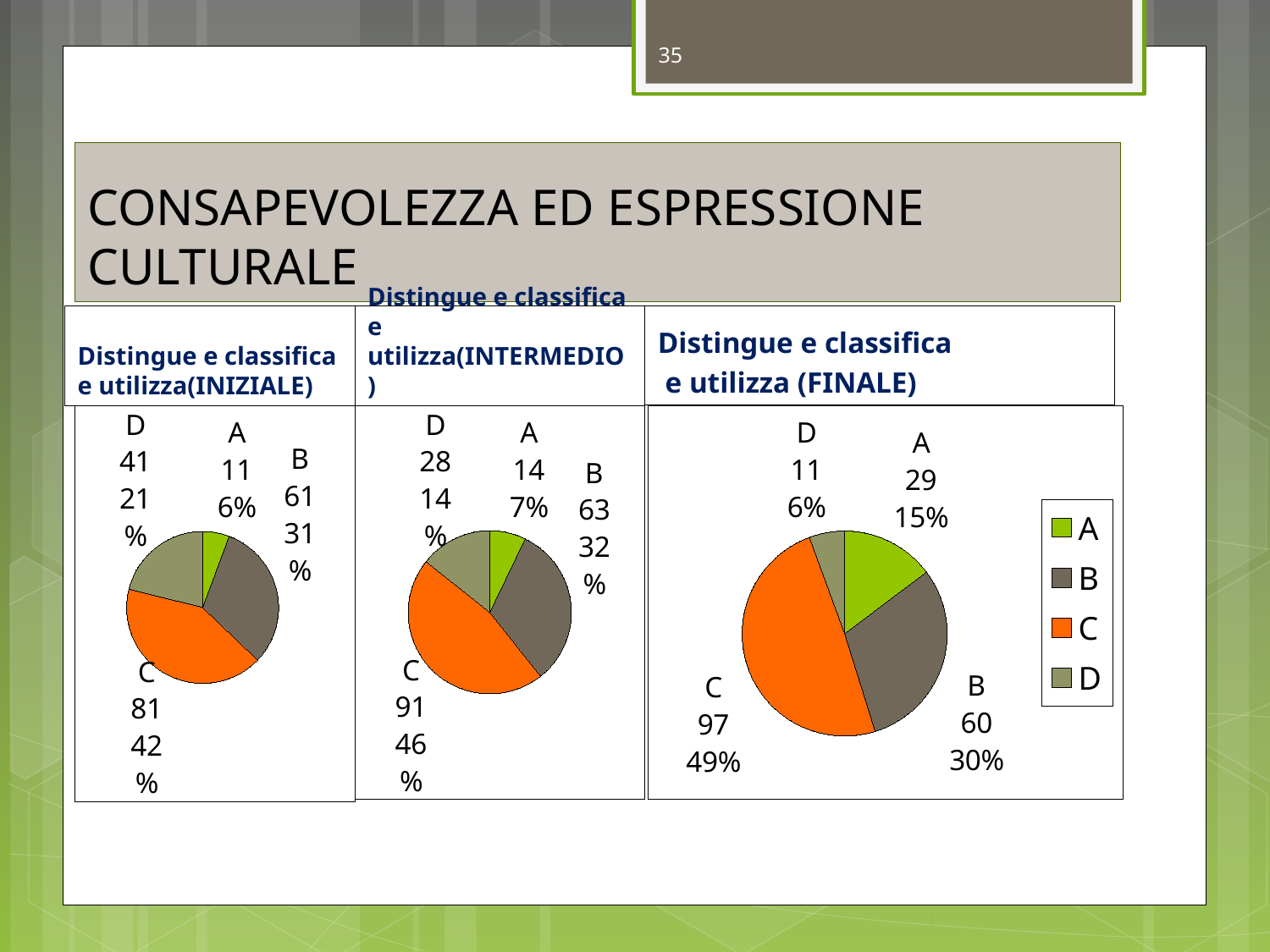
In the INTERMEDIO pie chart, what is the value for category D? 28 How many entries does the legend on the right of the slide list? 4 In the FINALE pie chart, which is larger, the value for B or the value for D? B How many categories does the FINALE pie chart show? 4 In the FINALE pie chart, what is the value for category A? 29 In the INTERMEDIO pie chart, which category has the largest value? C In the FINALE pie chart, what percentage share does category C have? 49% In the INIZIALE pie chart, what is the value for category C? 81 In the INTERMEDIO pie chart, what is the difference between the values for C and B? 28 In the INIZIALE pie chart, which category has the smallest value? A What type of chart is used for the INIZIALE data? Pie chart In the INIZIALE pie chart, what percentage share does category B have? 31%